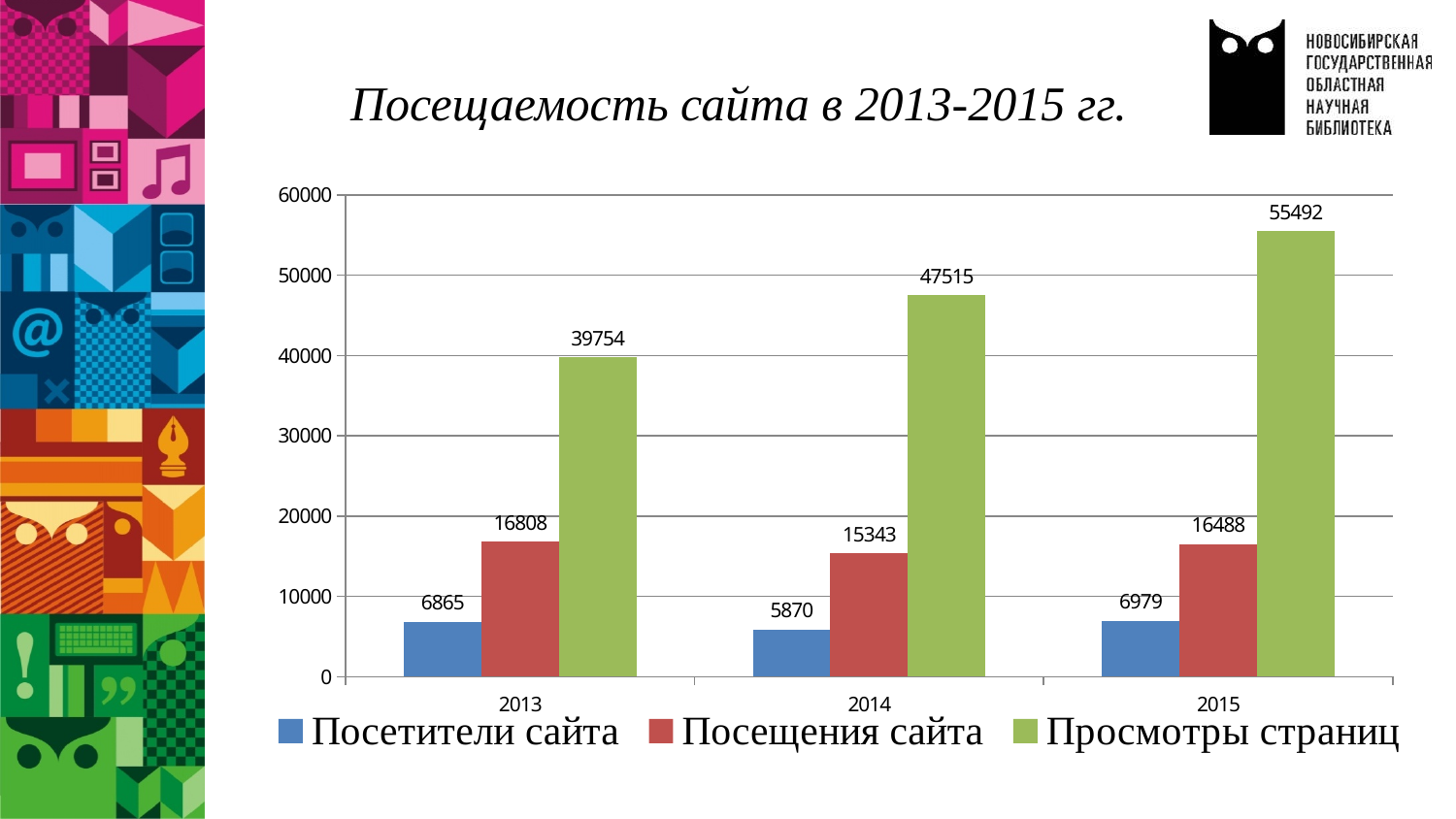
How many years are shown on the x axis? 3 How many series does the legend list? 3 In which year is Просмотры страниц highest? 2015 What is the difference between Просмотры страниц in 2015 and in 2014? 7977 Which is larger: Посещения сайта in 2013 or in 2015? 2013 What is the value for Посещения сайта in 2013? 16808 Is the value for Просмотры страниц in 2014 greater or less than 40000? greater What is the value for Посетители сайта in 2014? 5870 What kind of chart is shown on the slide? bar chart In which year is Посетители сайта lowest? 2014 What is the value for Просмотры страниц in 2015? 55492 Does Просмотры страниц rise or fall from 2013 to 2015? rise